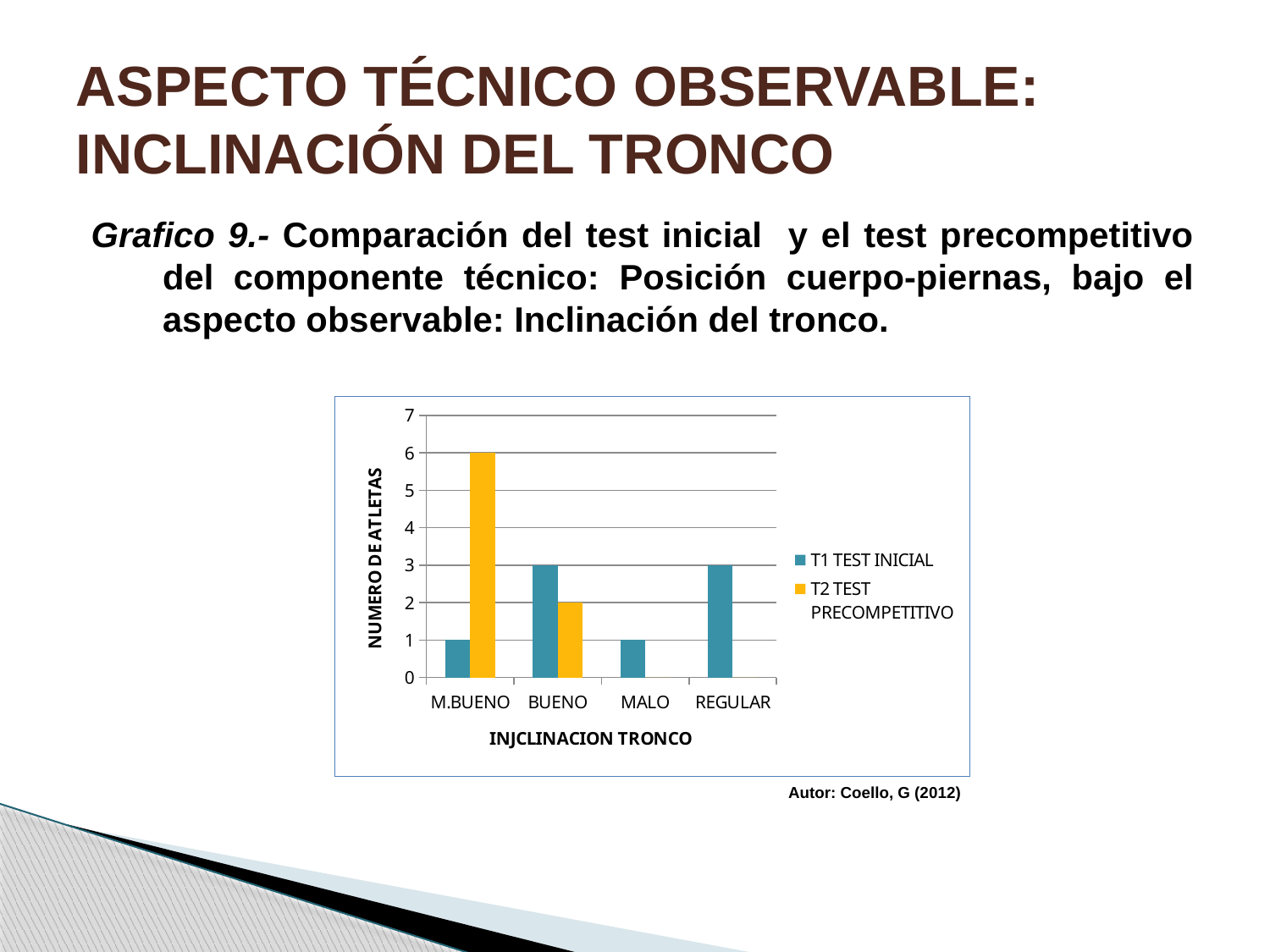
What is the value of T1 TEST INICIAL for MALO? 1 Which category has the highest value for T2 TEST PRECOMPETITIVO? M.BUENO How many series does the legend list? 2 What is the value of T2 TEST PRECOMPETITIVO for M.BUENO? 6 What is the value of T2 TEST PRECOMPETITIVO for BUENO? 2 How many categories are shown on the x axis? 4 For BUENO, which series has the larger value, T1 TEST INICIAL or T2 TEST PRECOMPETITIVO? T1 TEST INICIAL What is the label of the y axis? NUMERO DE ATLETAS Which category has the lowest value for T1 TEST INICIAL, M.BUENO or REGULAR? M.BUENO What kind of chart is shown on the slide? bar chart What is the value of T1 TEST INICIAL for BUENO? 3 What is the difference between T2 TEST PRECOMPETITIVO and T1 TEST INICIAL for M.BUENO? 5